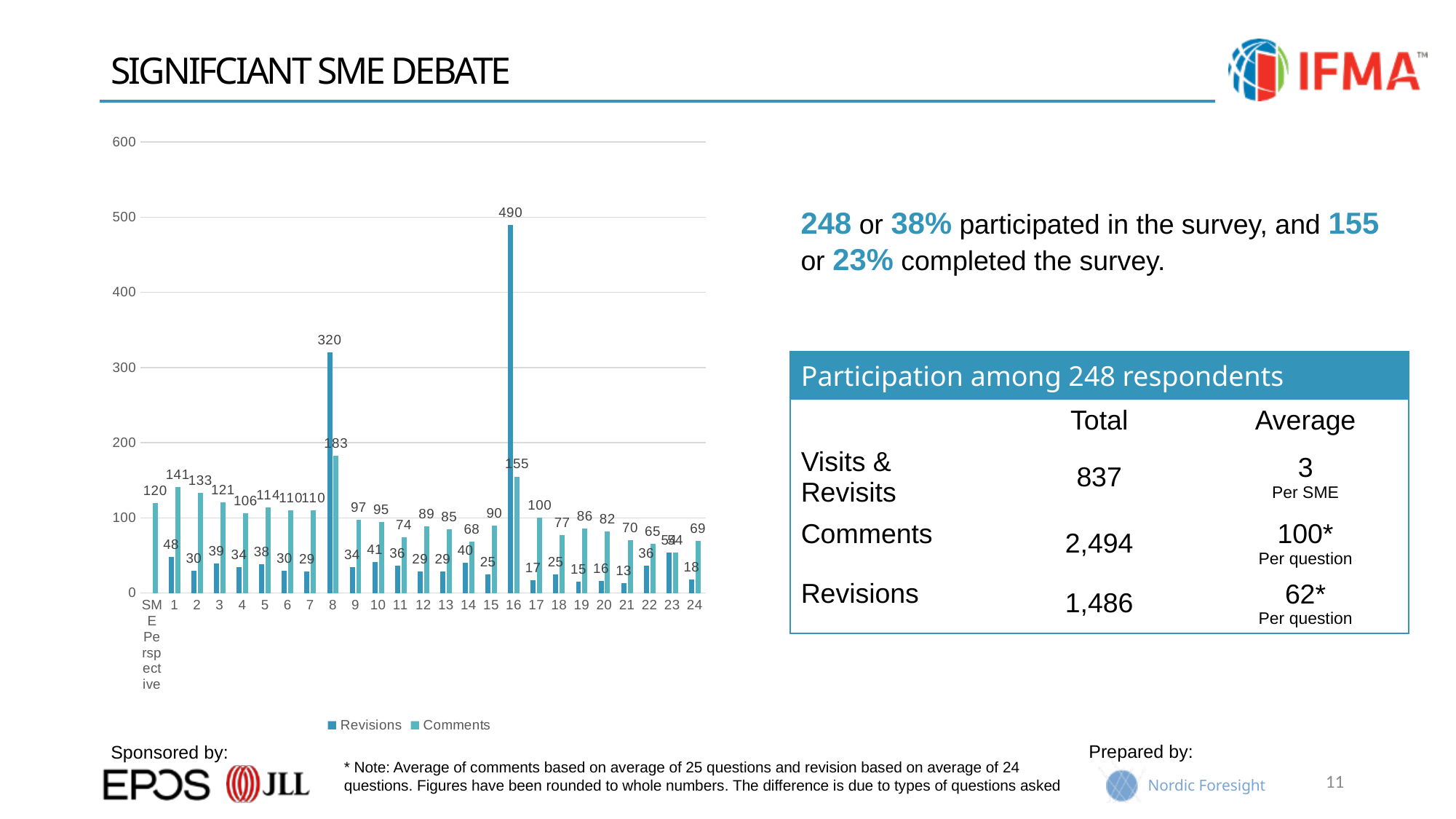
What is the Revisions value for question 16? 490 What are the two series named in the chart's legend? Revisions and Comments What is the Comments value for question 8? 183 Which category has the highest Comments value? 8 How many series does the chart's legend list? 2 What kind of chart is shown on the slide? bar chart What is the difference between the Revisions and Comments values for question 16? 335 Is the Revisions value for question 8 greater or less than 300? greater Which has more Comments, question 1 or question 2? question 1 Which question has the highest Revisions value? 16 What is the Comments value for the SME Perspective category? 120 Which question has the lowest Revisions value? 21